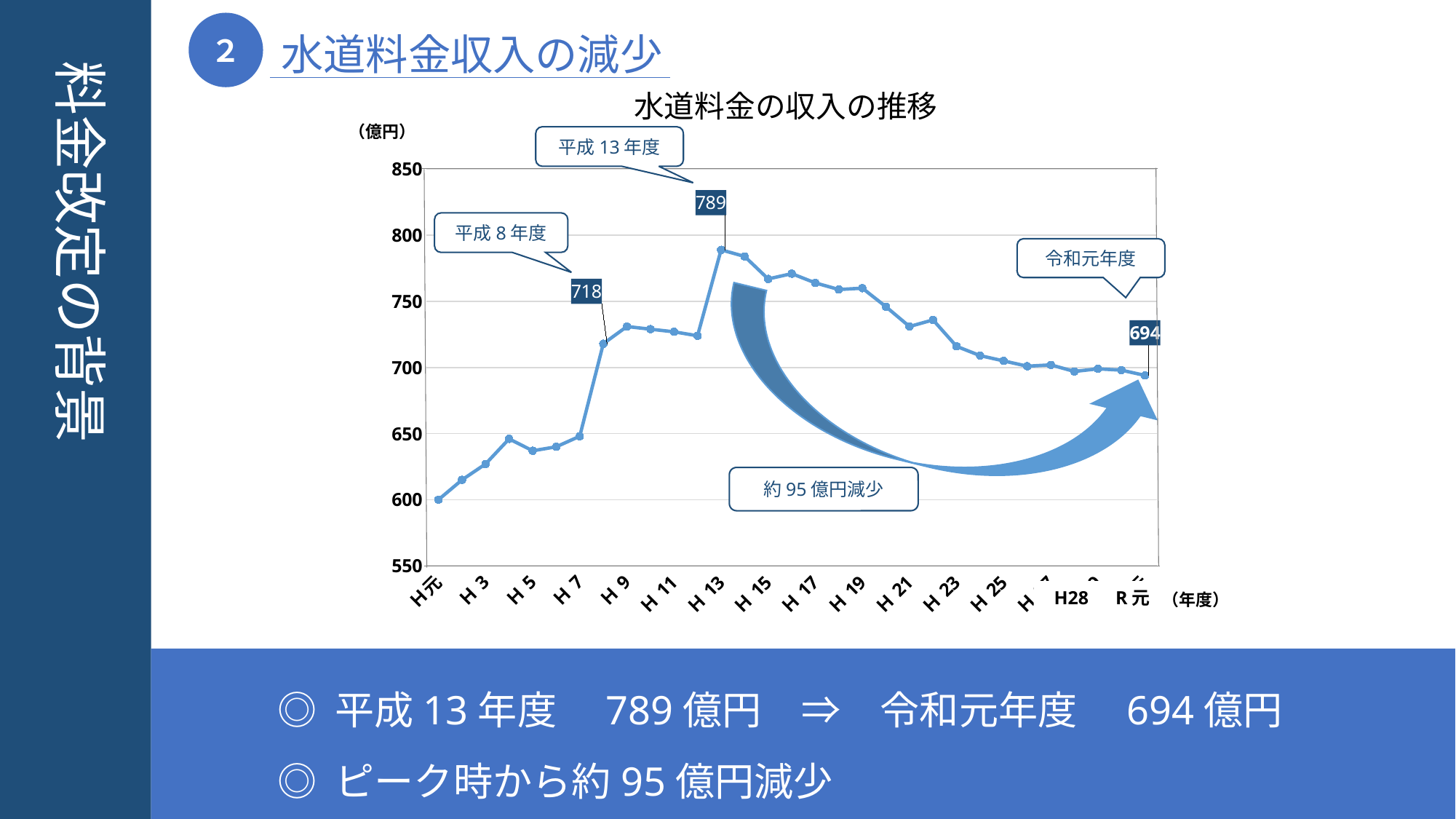
Is the value for H5 greater or less than 650? less What is the difference between the value for H13 and the value for R元? 95 Which is larger, the value for H8 or the value for H13? H13 What is the title of the chart? 水道料金の収入の推移 Which year has the lowest value on the chart? H元 What kind of chart is shown on the slide? line chart What is the value labelled for 平成13年度 (H13)? 789 Which year has the highest value on the chart? H13 What unit is shown on the vertical axis of the chart? 億円 What is the value labelled for 平成8年度 (H8)? 718 Do the values rise or fall from H13 to R元? fall What is the value labelled for 令和元年度 (R元)? 694